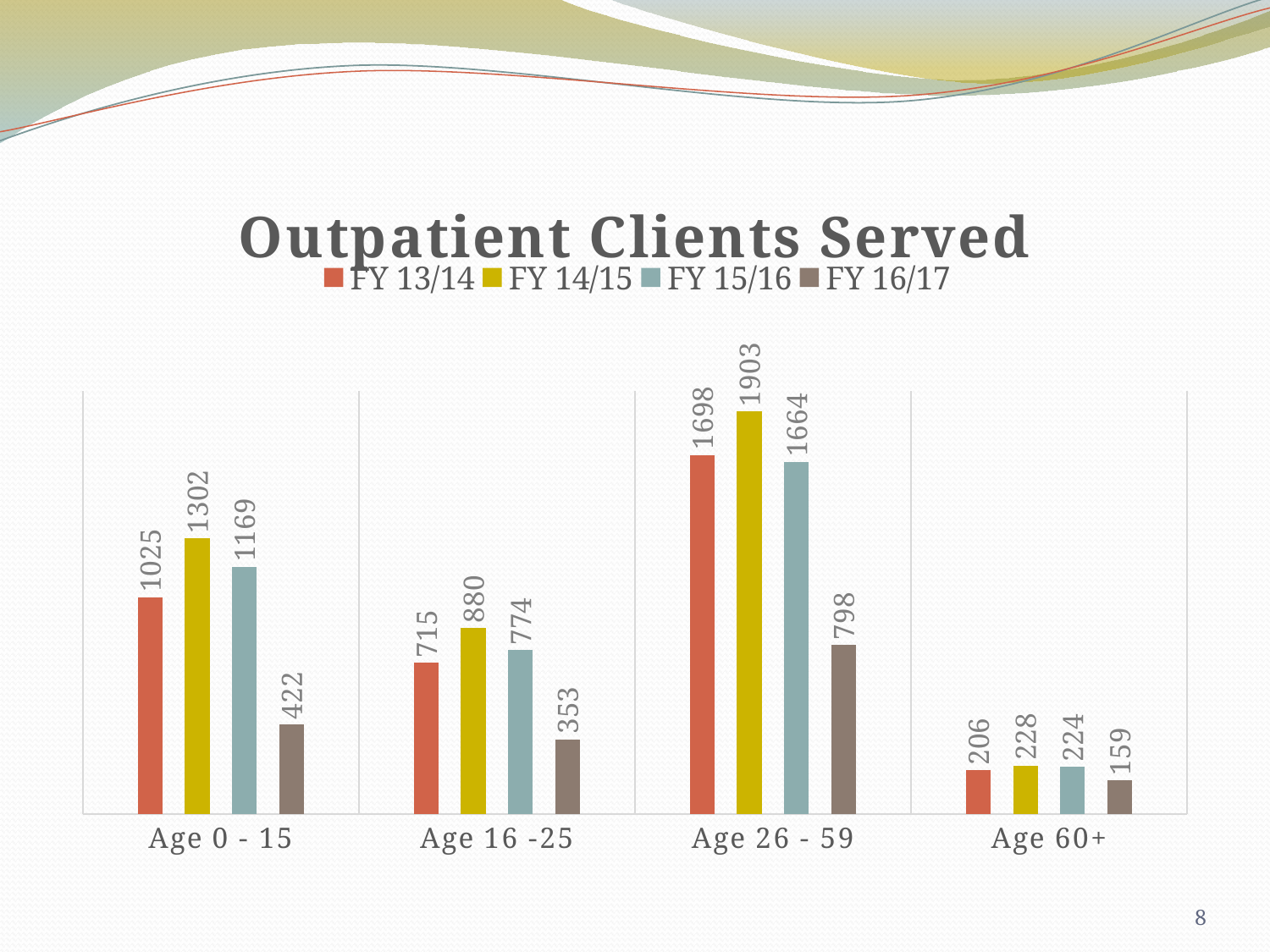
Which age category has the lowest value for FY 13/14? Age 60+ Which age category has the highest value for FY 15/16? Age 26 - 59 What kind of chart is shown on the slide? Bar chart How many age categories are shown on the x axis? 4 What is the difference between the FY 15/16 and FY 16/17 values in the Age 26 - 59 category? 866 What is the value for FY 13/14 in the Age 16 -25 category? 715 Which is larger in the Age 16 -25 category: the FY 15/16 value or the FY 13/14 value? FY 15/16 What is the difference between the FY 14/15 and FY 13/14 values in the Age 0 - 15 category? 277 How many series does the legend list? 4 What is the value for FY 14/15 in the Age 26 - 59 category? 1903 What is the title of the chart? Outpatient Clients Served What is the value for FY 16/17 in the Age 0 - 15 category? 422